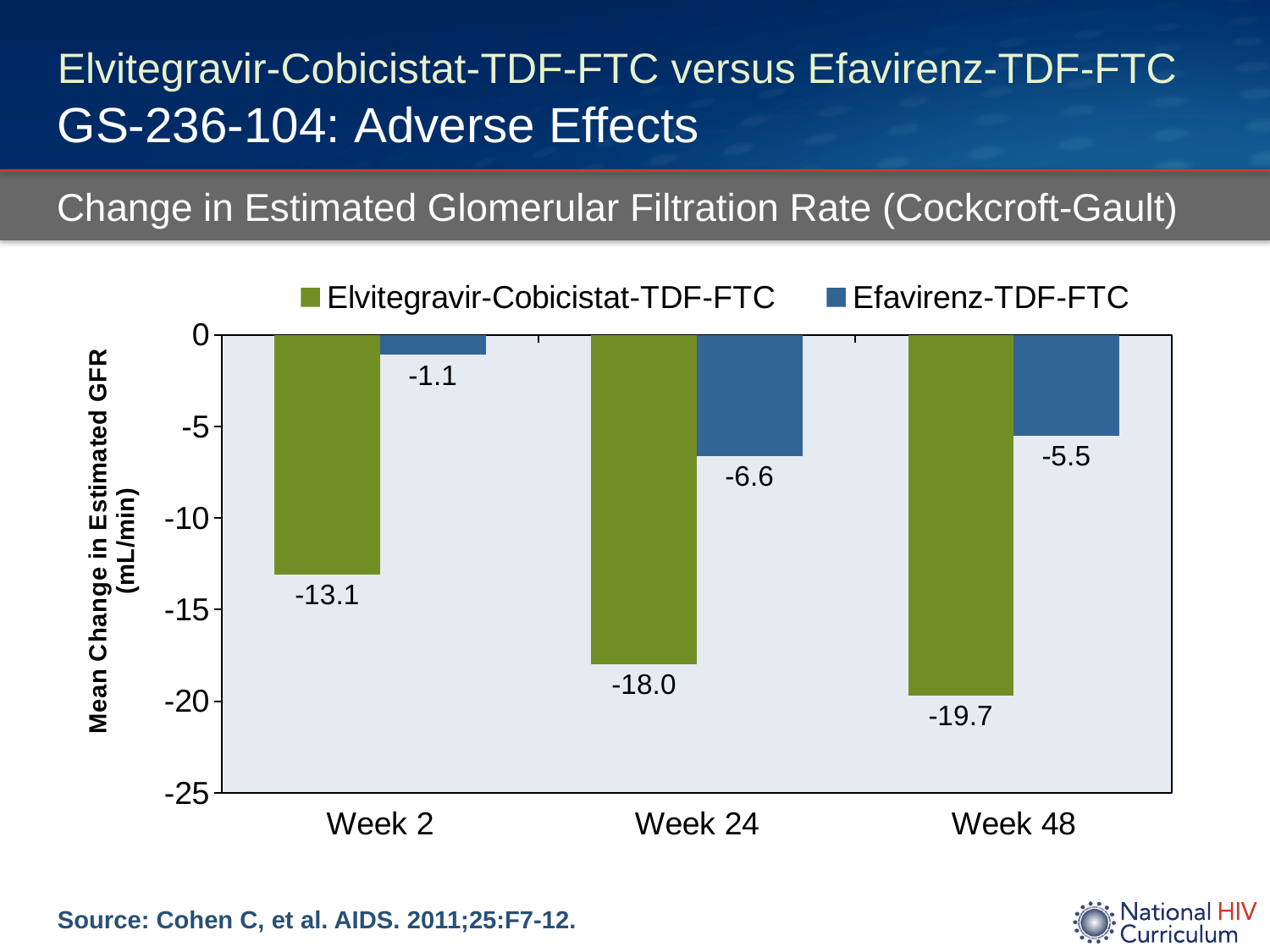
What is the mean change in estimated GFR for Efavirenz-TDF-FTC at Week 24? -6.6 At which week does Efavirenz-TDF-FTC show the smallest decrease in estimated GFR? Week 2 What is the mean change in estimated GFR for Elvitegravir-Cobicistat-TDF-FTC at Week 48? -19.7 How many time points are shown on the x axis? 3 What is the y-axis label of the chart? Mean Change in Estimated GFR (mL/min) What is the mean change in estimated GFR for Efavirenz-TDF-FTC at Week 2? -1.1 What is the mean change in estimated GFR for Elvitegravir-Cobicistat-TDF-FTC at Week 2? -13.1 What kind of chart is shown on the slide? Bar chart How many series does the legend list? 2 What is the difference between the Elvitegravir-Cobicistat-TDF-FTC and Efavirenz-TDF-FTC values at Week 24? 11.4 At which week does Elvitegravir-Cobicistat-TDF-FTC show the largest decrease in estimated GFR? Week 48 Which regimen has the larger decrease in estimated GFR at Week 48? Elvitegravir-Cobicistat-TDF-FTC